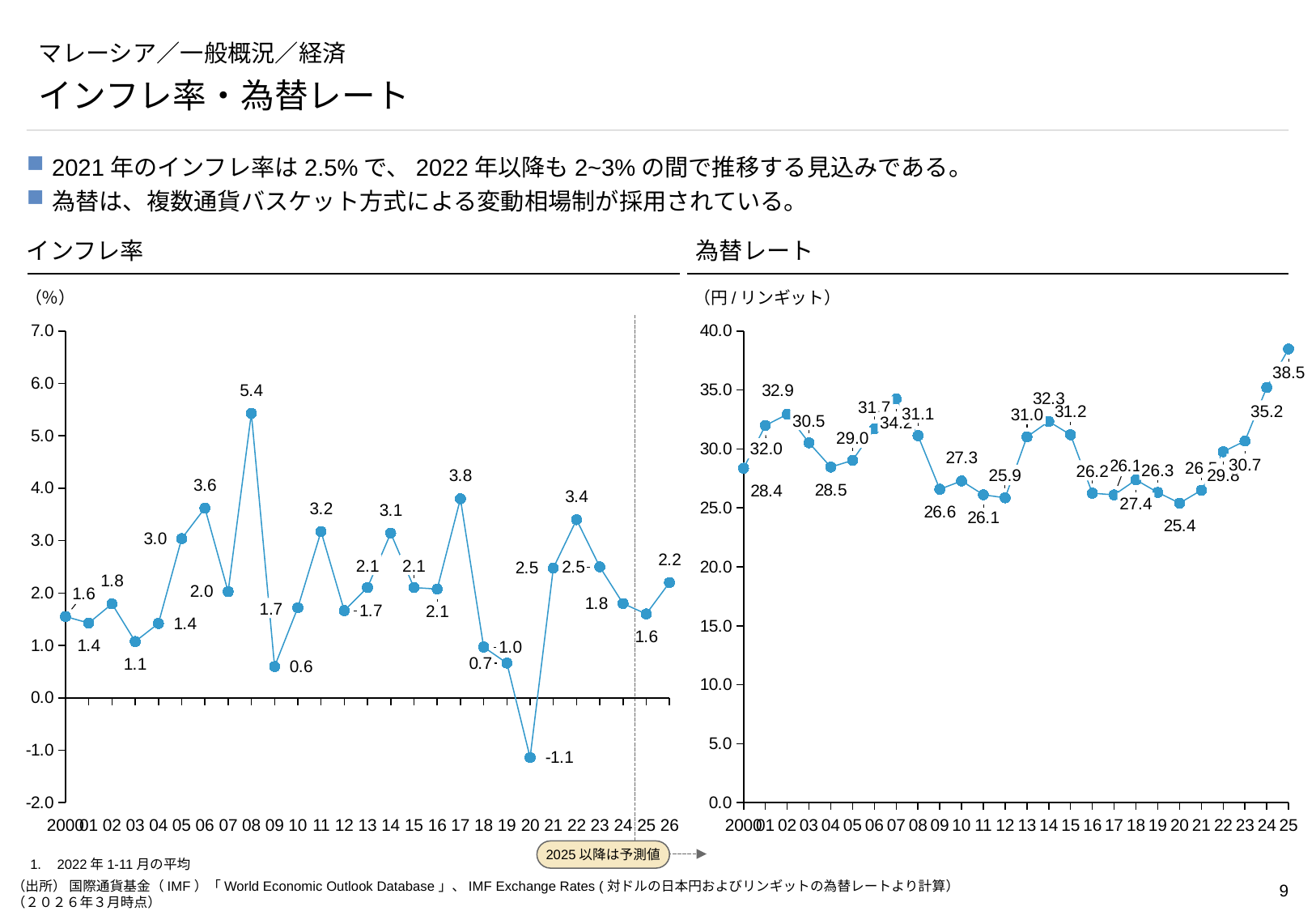
On the 為替レート chart, what is the difference between the 2025 value (38.5) and the 2024 value (35.2)? 3.3 On the インフレ率 chart, what is the value for 2020? -1.1 On the 為替レート chart, which is larger, the value for 2007 or the value for 2014? 2007 On the 為替レート chart, what is the value for 2025? 38.5 What unit is shown on the 為替レート chart's axis label? 円/リンギット On the インフレ率 chart, which year has the lowest inflation rate? 2020 What kind of chart is the 為替レート chart? line chart On the 為替レート chart, which year has the lowest value? 2020 On the インフレ率 chart, what is the difference between the 2008 value (5.4) and the 2006 value (3.6)? 1.8 On the インフレ率 chart, which year has the highest inflation rate? 2008 On the インフレ率 chart, what is the value for 2026? 2.2 On the インフレ率 chart, what is the inflation rate for 2008? 5.4